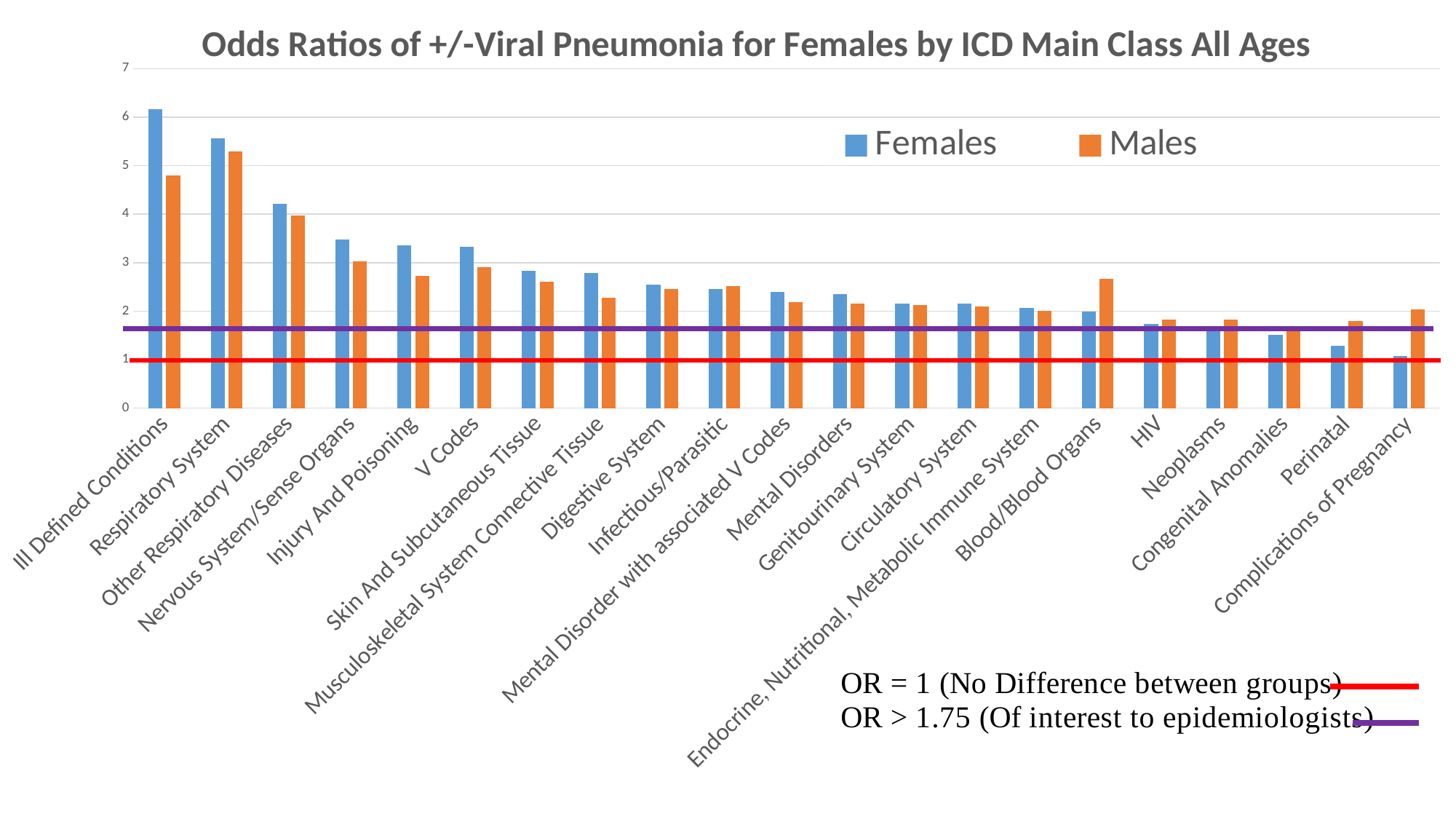
How many series does the legend list? 2 Which category has the highest Males odds ratio? Respiratory System Is the Females value for Complications of Pregnancy greater or less than 2? less Is the Males value for Ill Defined Conditions greater or less than 5? less Do the Females values generally rise or fall from left to right along the x axis? fall What kind of chart is shown on the slide? bar chart Is the Females value for Ill Defined Conditions greater or less than 6? greater For Blood/Blood Organs, which series has the larger value, Females or Males? Males For Respiratory System, which series has the larger value, Females or Males? Females How many ICD main class categories are shown on the x axis? 21 Which category has the lowest Females odds ratio? Complications of Pregnancy Which category has the highest Females odds ratio? Ill Defined Conditions